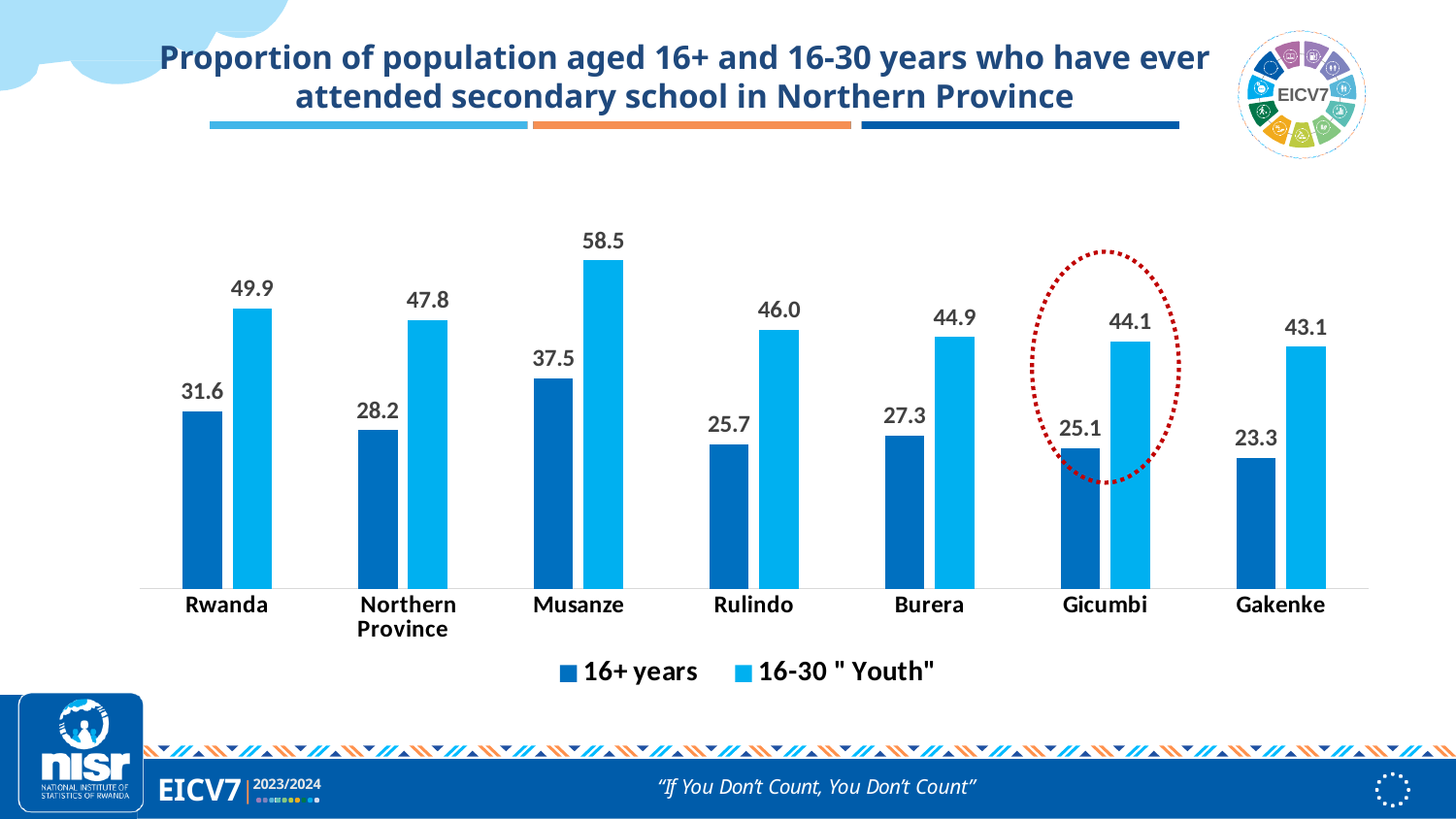
How many categories are shown on the x axis? 7 Which category has the highest value for the 16-30 "Youth" series? Musanze What is the value for the 16+ years series for Rwanda? 31.6 Which is larger: the 16-30 "Youth" value for Burera or for Gakenke? Burera What is the value for the 16-30 "Youth" series in Gicumbi? 44.1 Which category is highlighted with a red dotted circle? Gicumbi Which category has the lowest value for the 16+ years series? Gakenke What is the difference between the 16-30 "Youth" value and the 16+ years value in Rulindo? 20.3 What kind of chart is shown on the slide? Bar chart How many series does the legend list? 2 What is the title of the chart? Proportion of population aged 16+ and 16-30 years who have ever attended secondary school in Northern Province What is the value for the 16+ years series in Musanze? 37.5